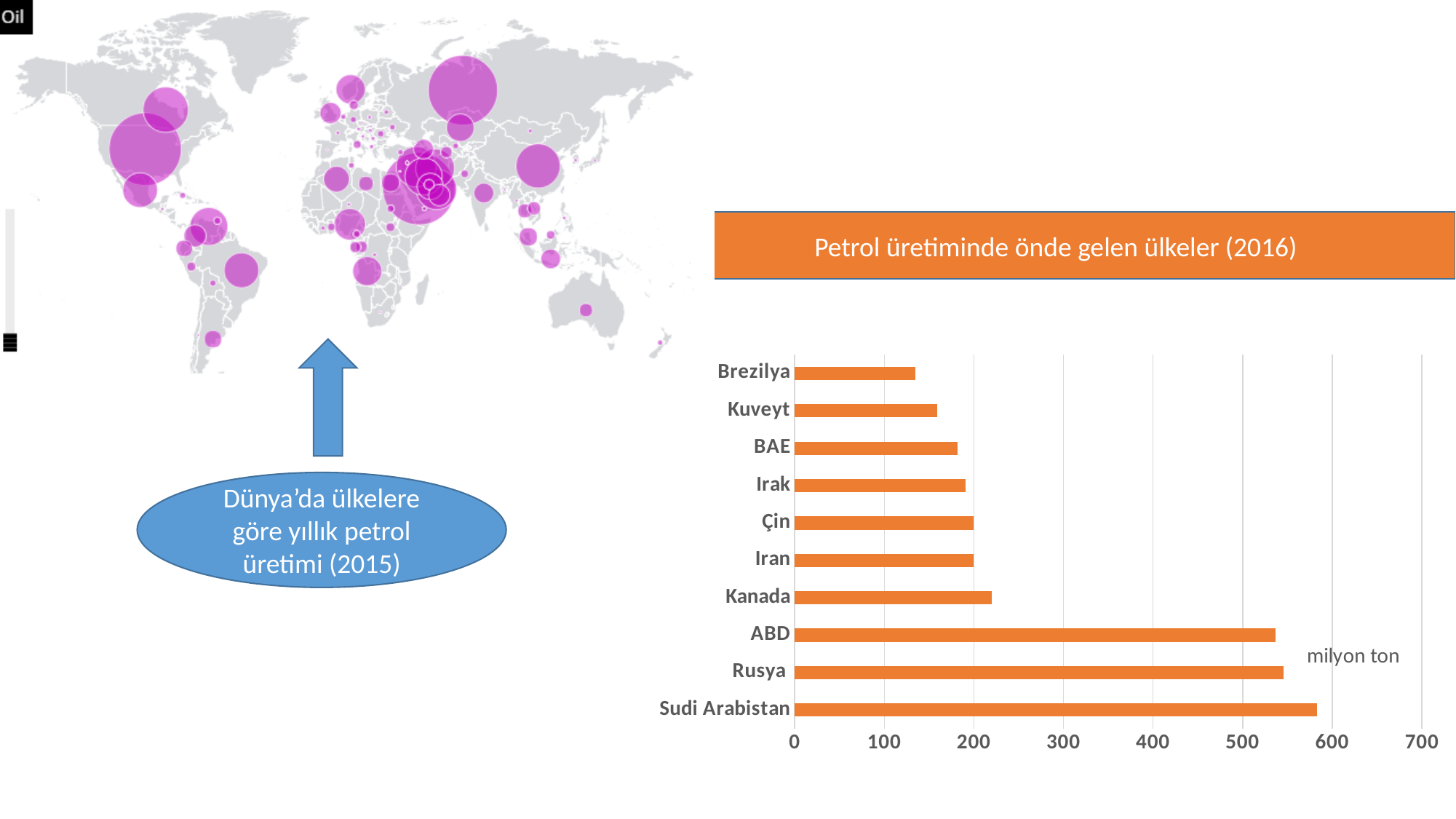
Is the value for Brezilya greater or less than 200? less Is the value for Kanada greater or less than 200? greater Is the value for Sudi Arabistan greater or less than 500? greater What is the title shown above the bar chart? Petrol üretiminde önde gelen ülkeler (2016) Which country has the highest value in the bar chart? Sudi Arabistan Which country has the lowest value in the bar chart? Brezilya Which has a larger value in the bar chart, ABD or Kanada? ABD How many countries are shown in the bar chart? 10 Which has a larger value in the bar chart, Irak or Kuveyt? Irak What kind of chart is shown under the title 'Petrol üretiminde önde gelen ülkeler (2016)'? bar chart What unit is indicated next to the bars in the chart? milyon ton